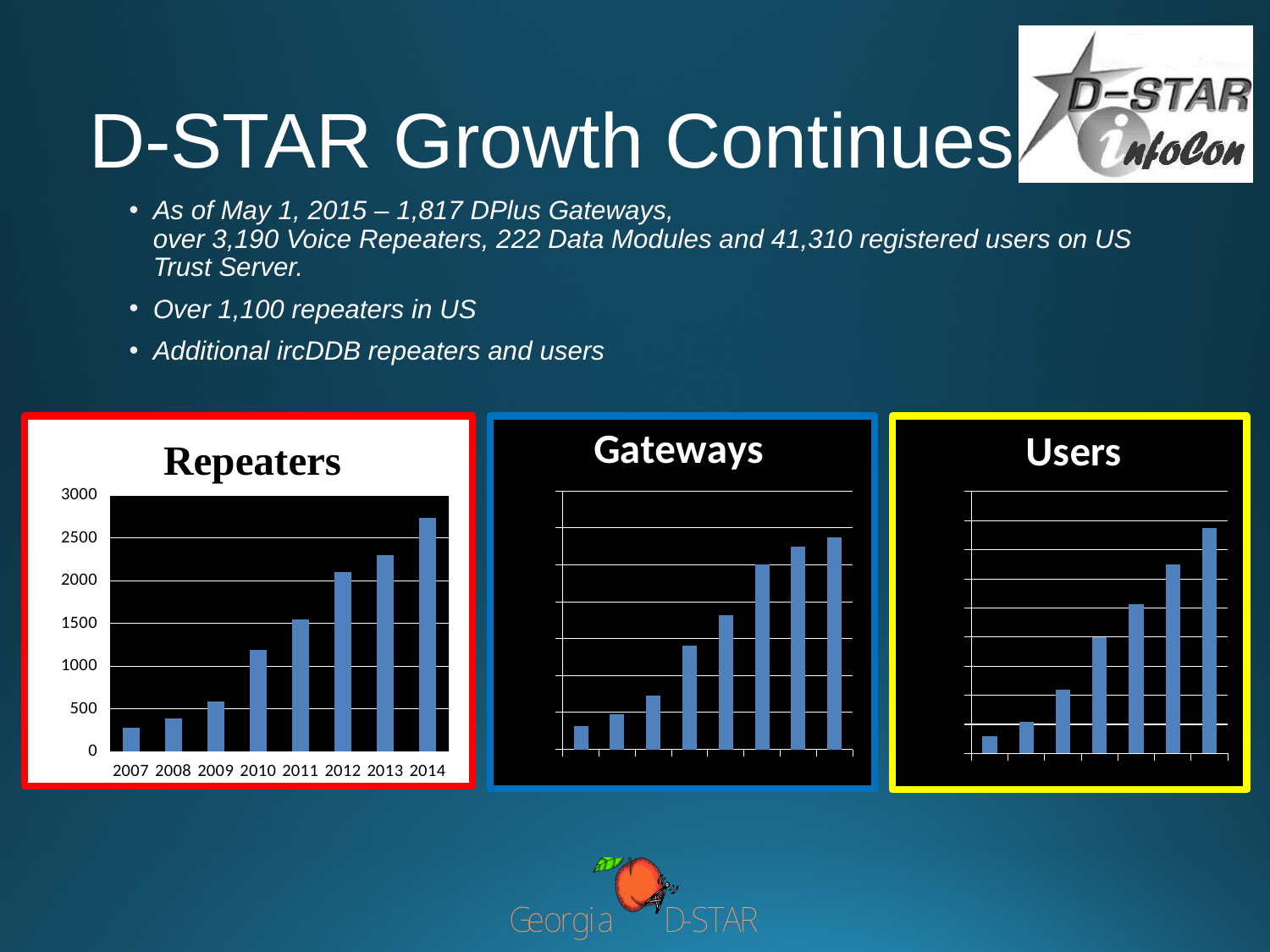
In the Repeaters chart, is the value for 2013 greater or less than 2500? less In the Gateways chart, do the bars rise or fall from left to right? rise In the Repeaters chart, which year has the highest value? 2014 In the Repeaters chart, which year has the lowest value? 2007 In the Repeaters chart, how many years are shown on the x axis? 8 In the Repeaters chart, is the value for 2010 greater or less than 1000? greater In the Users chart, how many bars are plotted? 7 In the Repeaters chart, which year has the larger value, 2011 or 2012? 2012 In the Repeaters chart, do the values rise or fall from 2007 to 2014? rise In the Repeaters chart, what kind of chart is used? bar chart In the Repeaters chart, is the value for 2009 greater or less than 1000? less